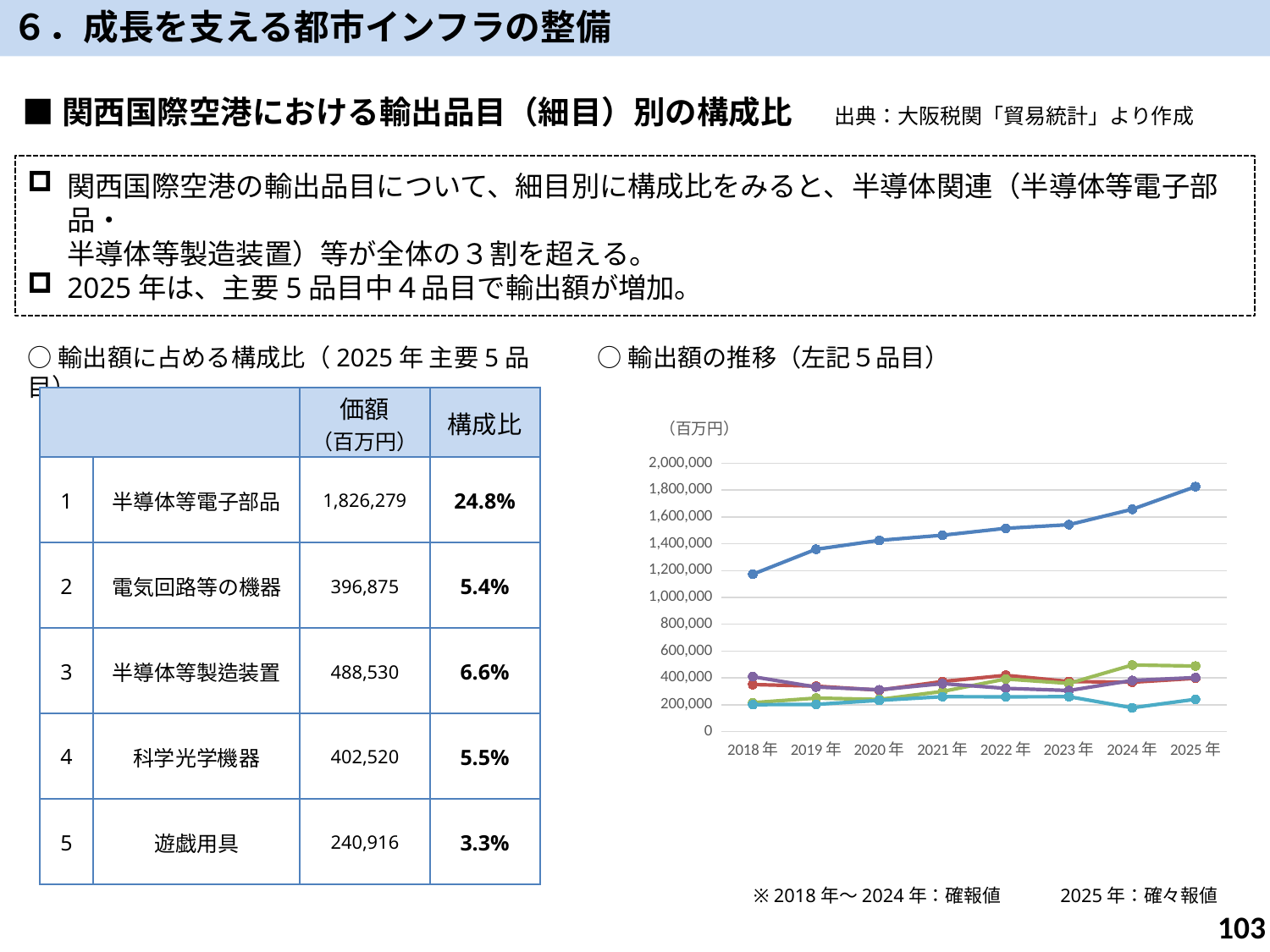
How many years are plotted along the x axis of the 「輸出額の推移」 chart? 8 What is the highest tick value shown on the y axis of the 「輸出額の推移」 chart? 2,000,000 In the 「輸出額の推移」 chart, are the values of the four lower lines in 2025年 greater or less than 600,000? less What unit is shown at the top of the y axis of the 「輸出額の推移」 chart? （百万円） In the 「輸出額の推移」 chart, in which year is the top (blue) line at its lowest value? 2018年 In the 「輸出額の推移」 chart, in which year does the top (blue) line reach its highest value? 2025年 In the 「輸出額の推移」 chart, is the value of the top (blue) line in 2022年 greater or less than 1,400,000? greater In the 「輸出額の推移」 chart, is the value of the top (blue) line in 2024年 greater or less than 1,600,000? greater How many lines are plotted in the 「輸出額の推移」 chart? 5 In the 「輸出額の推移」 chart, does the top (blue) line rise or fall from 2018年 to 2025年? rise What kind of chart is shown under 「輸出額の推移（左記５品目）」? line chart